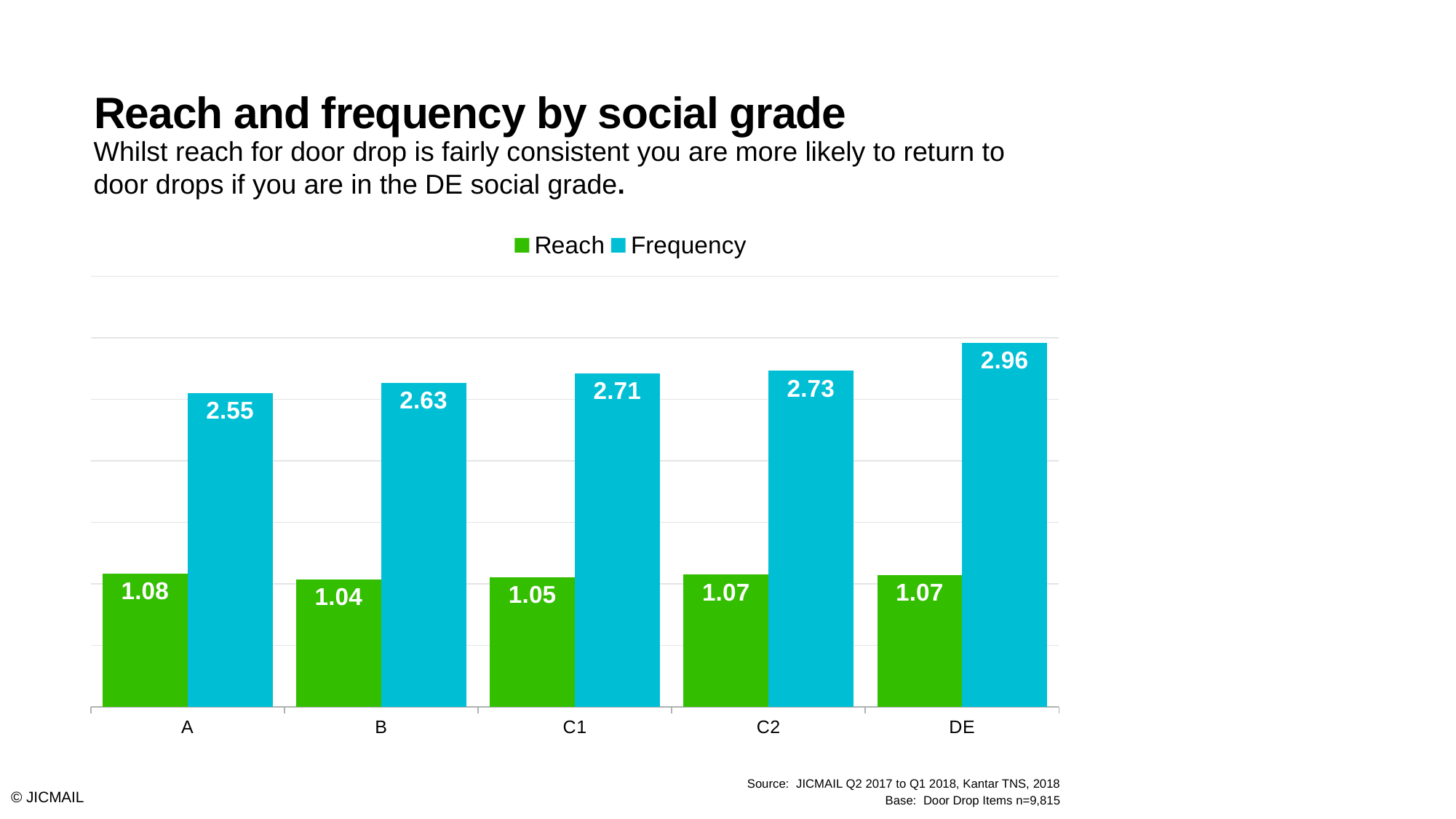
What is the difference between the Frequency and Reach values for C1? 1.66 What is the Reach value for social grade B? 1.04 What kind of chart is shown on the slide? Bar chart What is the Frequency value for social grade A? 2.55 Do the Frequency values rise or fall from A to DE along the x axis? Rise Which social grade has the highest Frequency value? DE What is the Frequency value for social grade DE? 2.96 How many series does the legend list? 2 How many social grade categories are shown on the x axis? 5 What is the difference between the Frequency values for DE and A? 0.41 Which is larger, the Frequency value for B or the Frequency value for C2? C2 Which social grade has the lowest Reach value? B